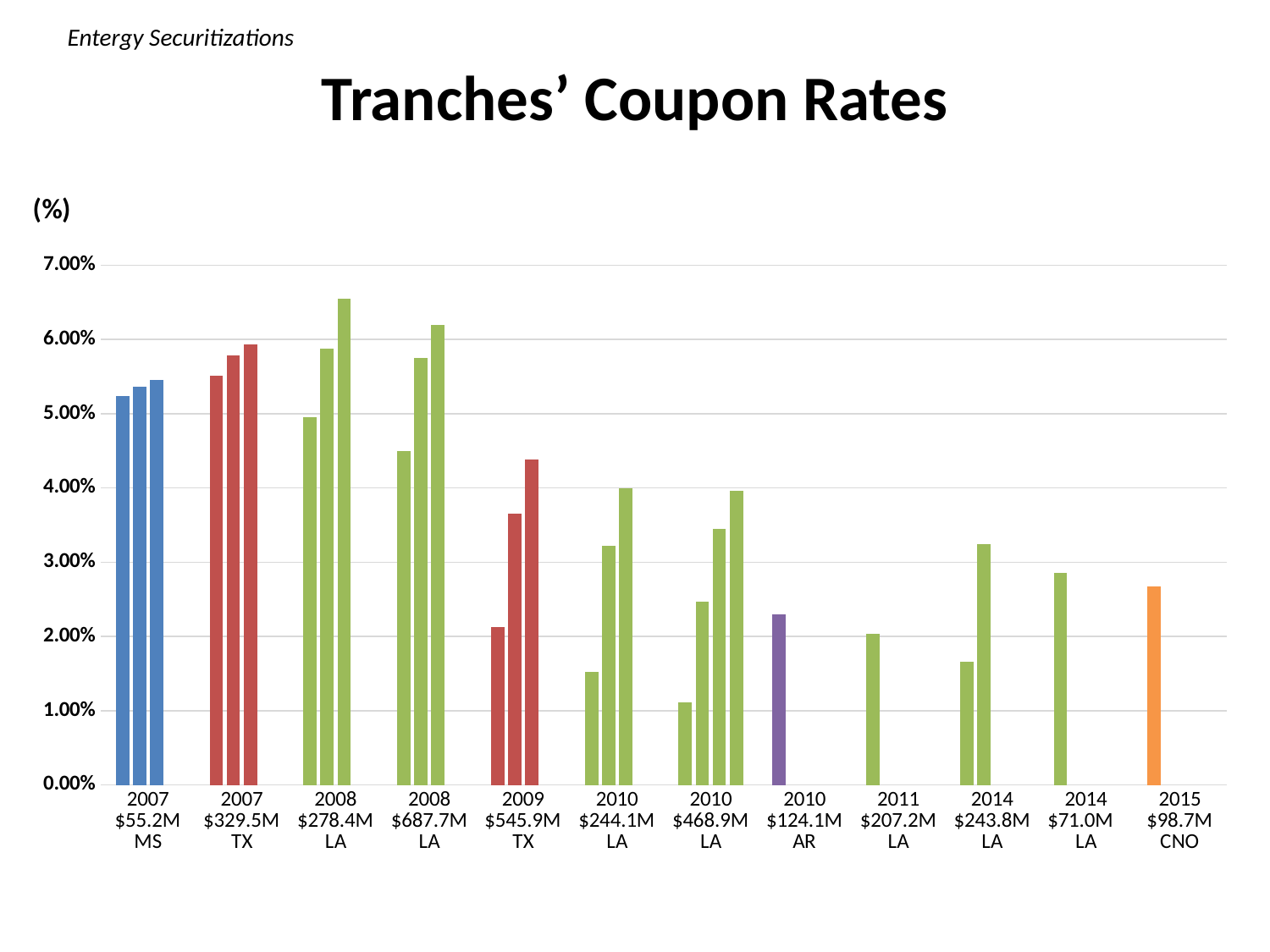
What colour is the bar for 2015 $98.7M CNO? orange How many bars are shown for the 2010 $468.9M LA category? 4 What kind of chart is shown on the slide? bar chart Which category contains the tallest bar on the chart? 2008 $278.4M LA What is the title of the chart? Tranches' Coupon Rates Which is larger, the bar for 2010 $124.1M AR or the bar for 2014 $71.0M LA? 2014 $71.0M LA Is the value for 2015 $98.7M CNO greater or less than 2.00%? greater Which category contains the shortest bar on the chart? 2010 $468.9M LA Is the value for 2010 $124.1M AR greater or less than 2.00%? greater How many securitization categories are shown along the x axis? 12 Is the tallest bar for 2009 $545.9M TX greater or less than 4.00%? greater